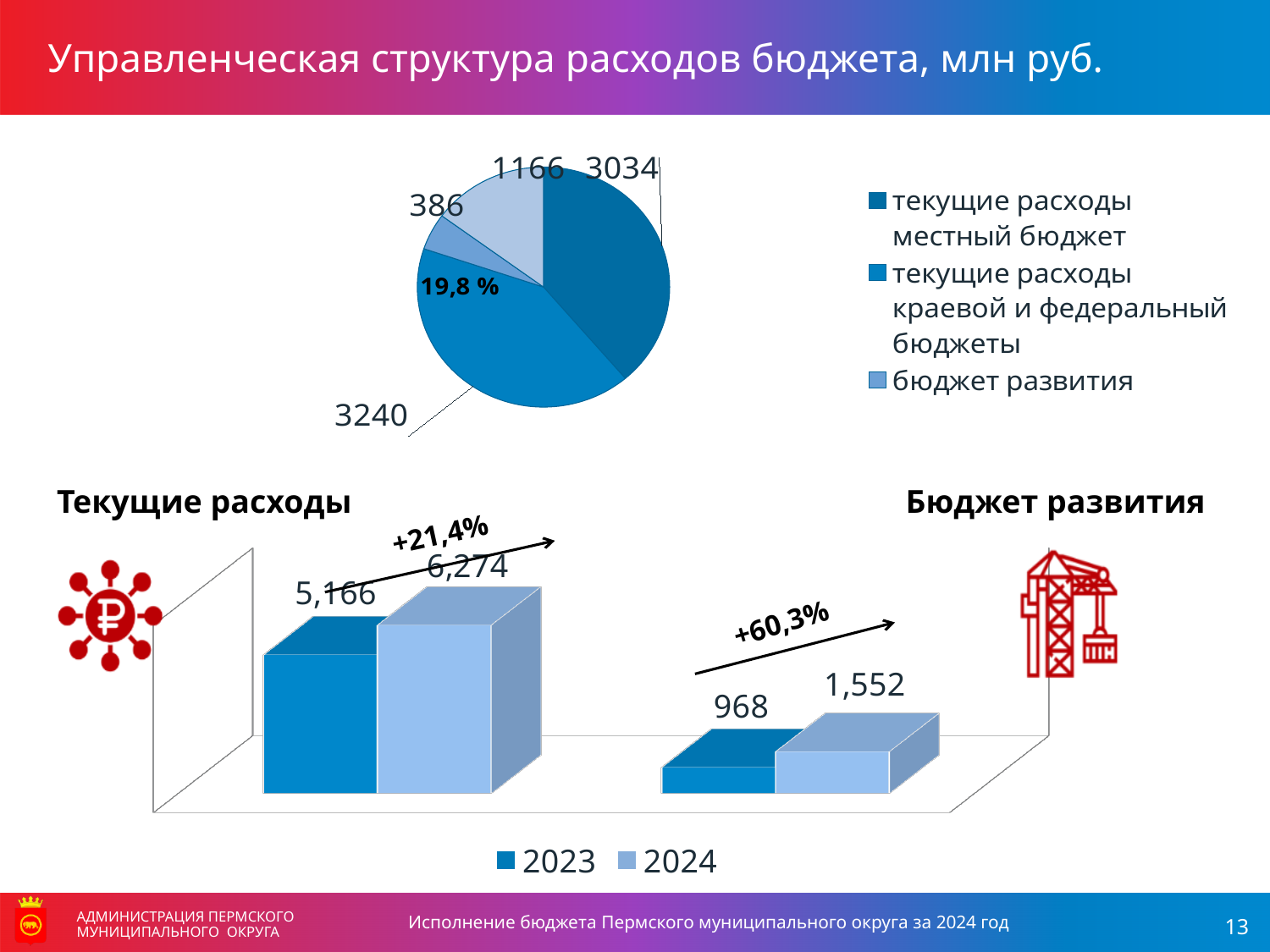
In the bar chart, what is the difference between the 2024 and 2023 values for Текущие расходы? 1,108 What percentage is printed inside the pie chart? 19,8 % How many slices does the pie chart have? 4 In the bar chart, what is the value for Текущие расходы in 2024? 6,274 In the pie chart, what is the value of the largest slice? 3240 What type of chart is shown at the bottom of the slide? bar chart What type of chart is shown at the top of the slide? pie chart In the bar chart, what growth percentage is shown for Бюджет развития? +60,3% How many entries does the legend of the pie chart list? 3 In the bar chart, what is the value for Бюджет развития in 2023? 968 In the pie chart, what is the value of the smallest slice? 386 In the bar chart, what is the difference between the 2024 and 2023 values for Бюджет развития? 584